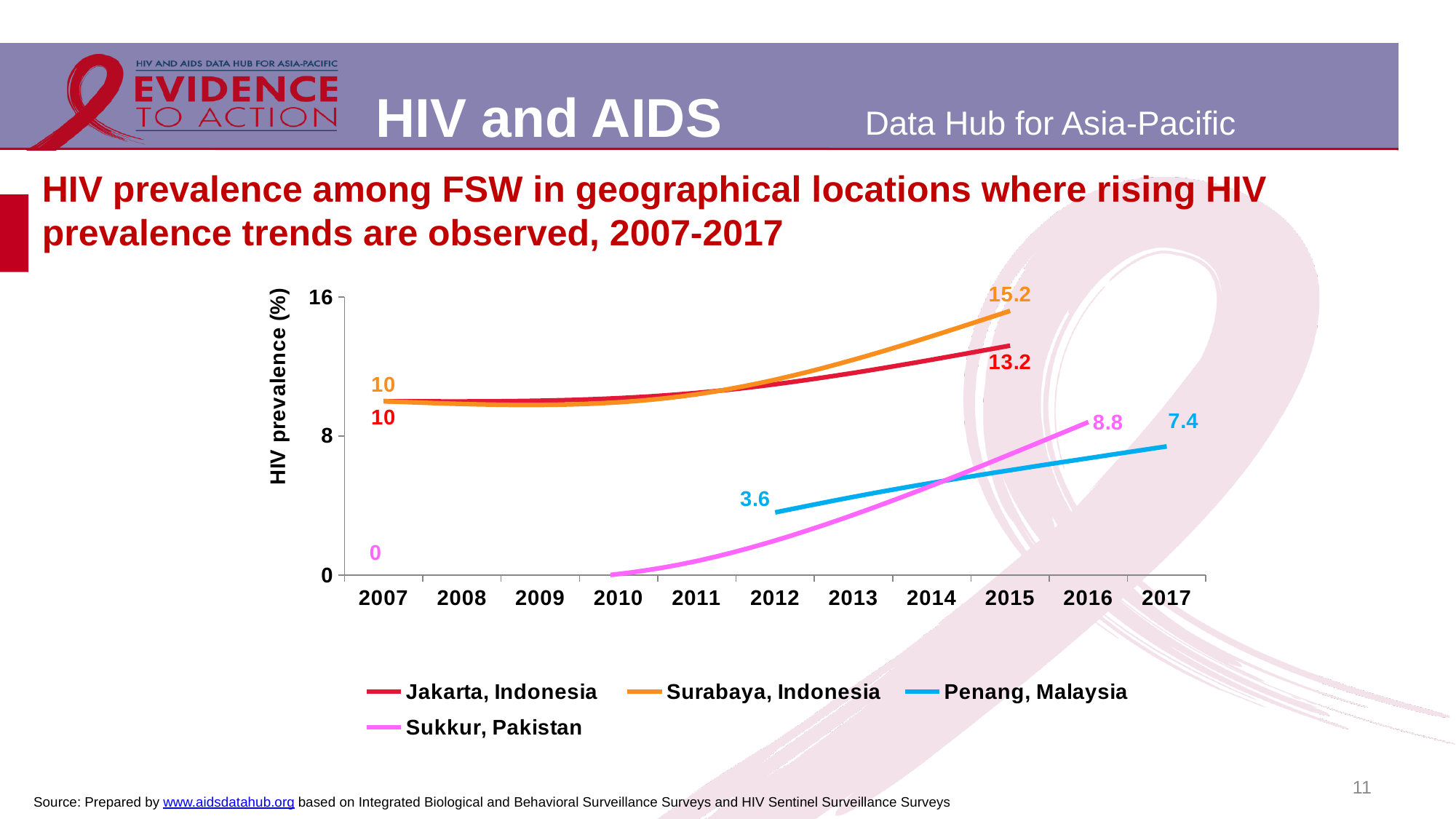
What is the HIV prevalence among FSW in Penang, Malaysia in 2012? 3.6 What is the HIV prevalence among FSW in Penang, Malaysia in 2017? 7.4 By how much did HIV prevalence among FSW in Surabaya, Indonesia increase from 2007 to 2015? 5.2 What kind of chart is shown on the slide? line chart What is the HIV prevalence among FSW in Sukkur, Pakistan in 2016? 8.8 Which location has the highest labelled HIV prevalence value on the chart? Surabaya, Indonesia What is the HIV prevalence among FSW in Jakarta, Indonesia in 2015? 13.2 How many series does the legend list? 4 Does the HIV prevalence for Sukkur, Pakistan rise or fall over the years shown? rise By how much did HIV prevalence among FSW in Penang, Malaysia increase from 2012 to 2017? 3.8 What is the HIV prevalence among FSW in Surabaya, Indonesia in 2015? 15.2 Which is larger in 2015: the HIV prevalence in Jakarta, Indonesia or in Surabaya, Indonesia? Surabaya, Indonesia